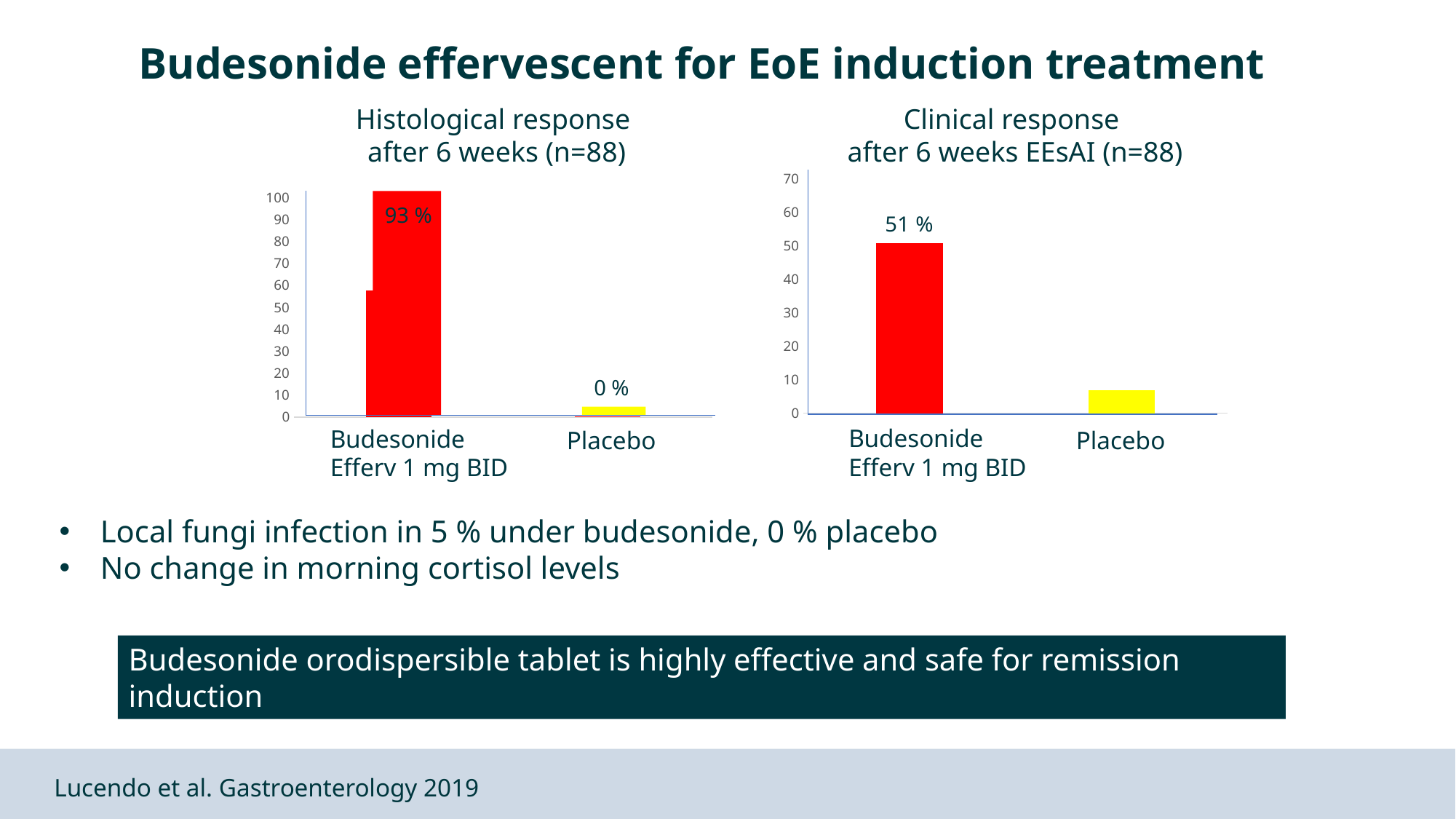
In the 'Clinical response after 6 weeks EEsAI (n=88)' chart, which category has the lowest value? Placebo In the 'Clinical response after 6 weeks EEsAI (n=88)' chart, is the value for Placebo greater or less than 10? less In the 'Histological response after 6 weeks (n=88)' chart, what is the value for Budesonide Efferv 1 mg BID? 93 % In the 'Clinical response after 6 weeks EEsAI (n=88)' chart, is the value for Budesonide Efferv 1 mg BID greater or less than 40? greater What colour is the Placebo bar in the 'Clinical response after 6 weeks EEsAI (n=88)' chart? Yellow In the 'Histological response after 6 weeks (n=88)' chart, what is the value for Placebo? 0 % What kind of chart is the 'Histological response after 6 weeks (n=88)' chart? Bar chart In the 'Clinical response after 6 weeks EEsAI (n=88)' chart, which is larger, the value for Budesonide Efferv 1 mg BID or for Placebo? Budesonide Efferv 1 mg BID In the 'Clinical response after 6 weeks EEsAI (n=88)' chart, what is the value for Budesonide Efferv 1 mg BID? 51 % In the 'Histological response after 6 weeks (n=88)' chart, what is the difference between the Budesonide Efferv 1 mg BID value and the Placebo value? 93 % In the 'Histological response after 6 weeks (n=88)' chart, which category has the highest value? Budesonide Efferv 1 mg BID How many categories are shown in the 'Clinical response after 6 weeks EEsAI (n=88)' chart? 2